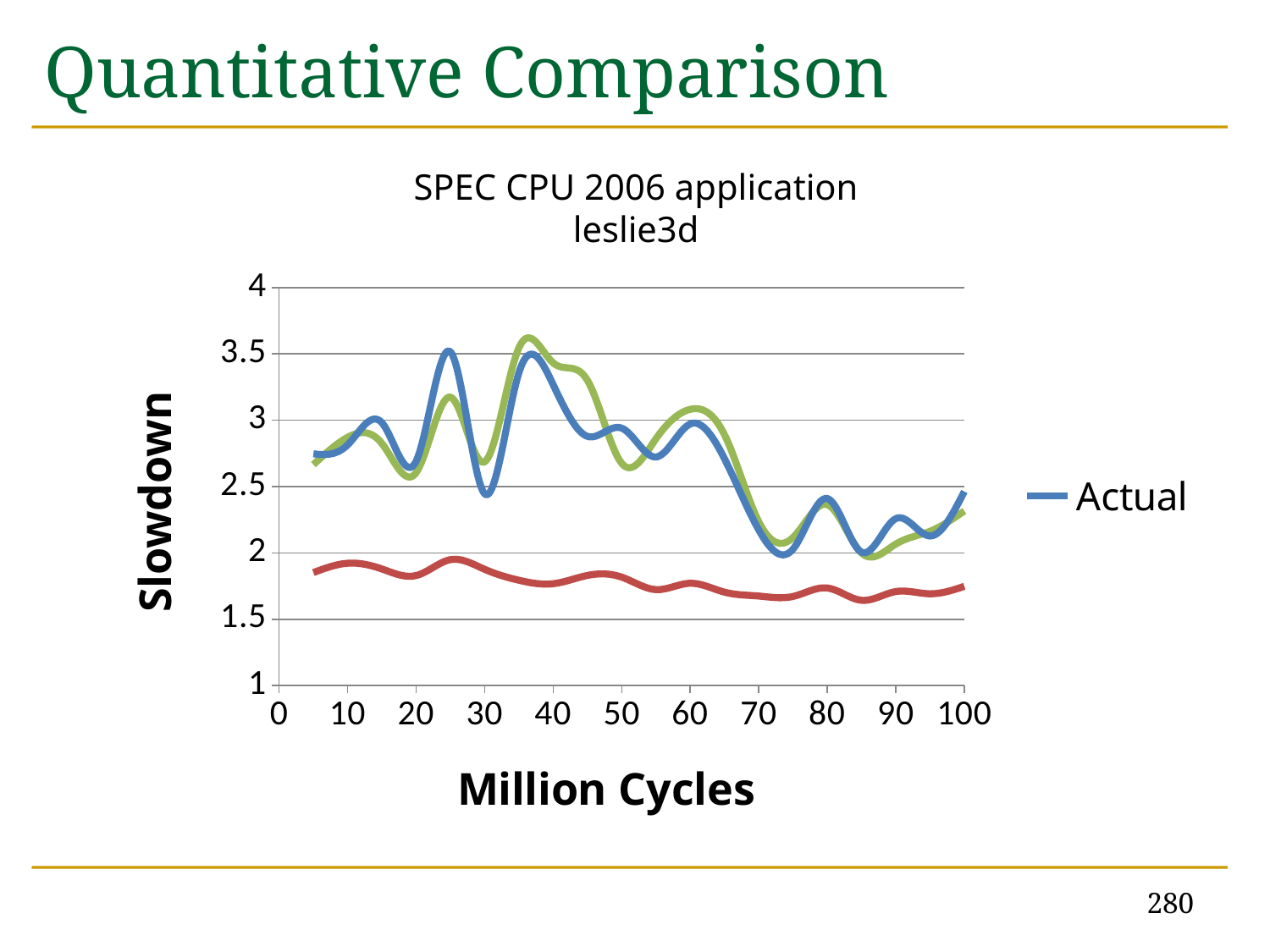
Is the Actual value at 100 million cycles greater or less than 3? less How many series does the chart legend list? 1 Is the Actual value at 30 million cycles greater or less than 3? less Is the Actual value at 10 million cycles greater or less than 2.5? greater What kind of chart is shown on the slide? line chart Does the Actual series generally rise or fall from 0 to 100 million cycles? fall What is the title of the chart? SPEC CPU 2006 application leslie3d What is the label on the vertical axis of the chart? Slowdown